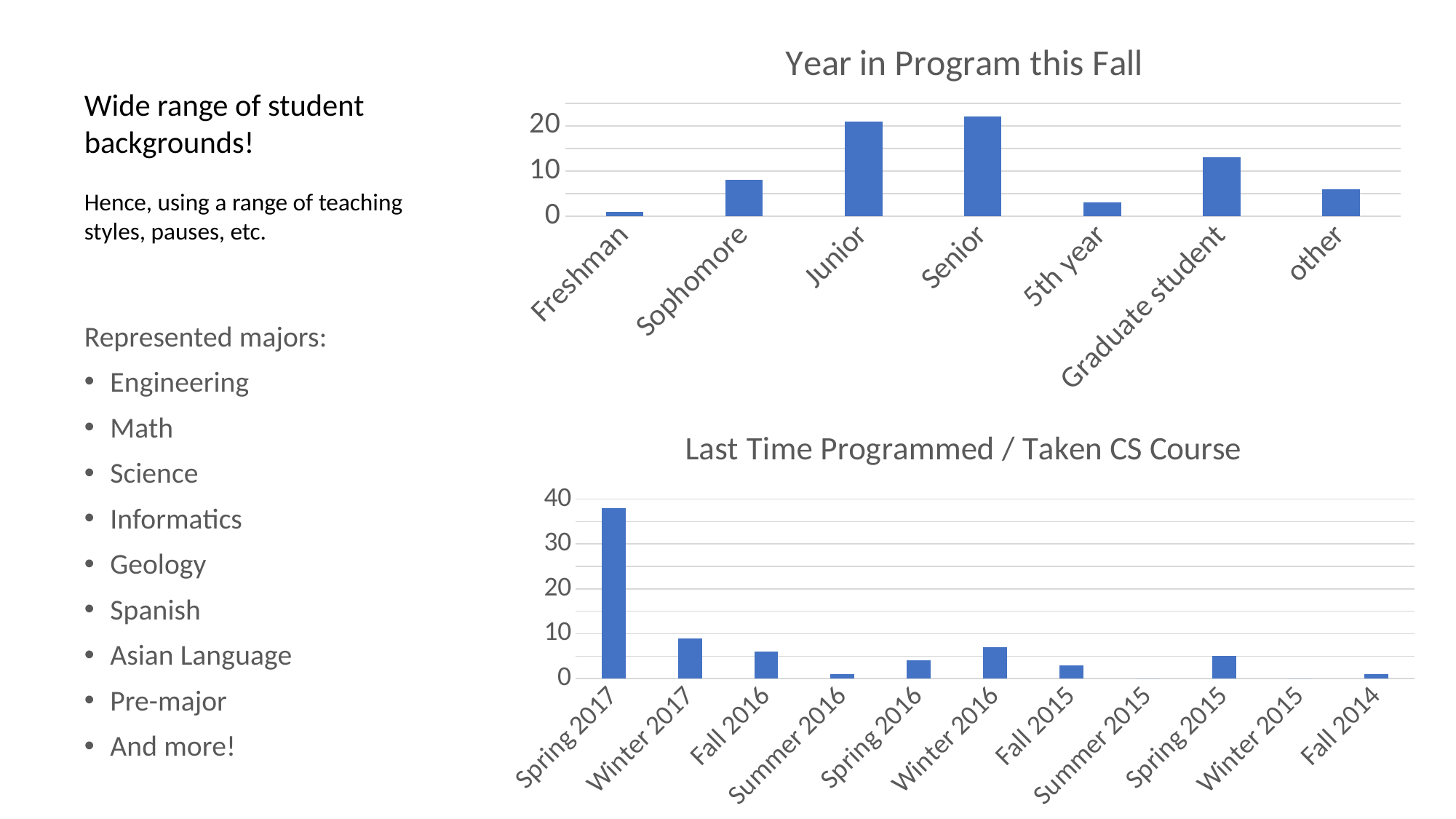
In the 'Year in Program this Fall' chart, which is larger, the value for Graduate student or the value for other? Graduate student What type of chart is the 'Year in Program this Fall' chart? bar chart In the 'Last Time Programmed / Taken CS Course' chart, which is larger, the value for Winter 2016 or the value for Summer 2016? Winter 2016 In the 'Year in Program this Fall' chart, which is larger, the value for Junior or the value for 5th year? Junior How many categories are shown on the x axis of the 'Last Time Programmed / Taken CS Course' chart? 11 In the 'Last Time Programmed / Taken CS Course' chart, is the value for Spring 2017 greater or less than 30? greater In the 'Year in Program this Fall' chart, is the value for Graduate student greater or less than 10? greater In the 'Last Time Programmed / Taken CS Course' chart, is the value for Winter 2017 greater or less than 10? less In the 'Year in Program this Fall' chart, which category has the lowest value? Freshman How many categories are shown on the x axis of the 'Year in Program this Fall' chart? 7 In the 'Last Time Programmed / Taken CS Course' chart, which category has the highest value? Spring 2017